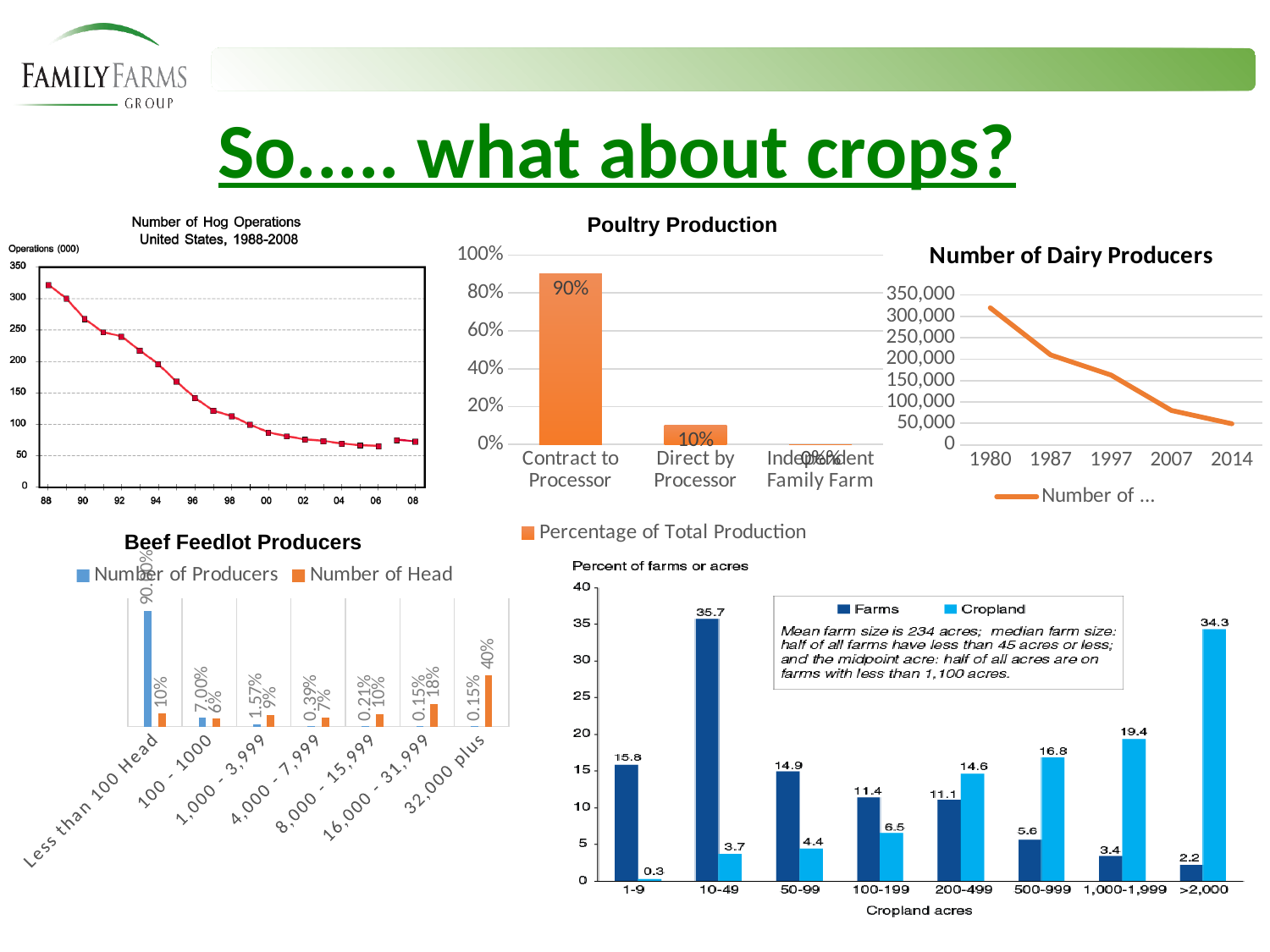
In the Number of Dairy Producers chart, is the value for 2014 greater or less than 100,000? less In the Poultry Production chart, how many categories are shown on the x axis? 3 In the Beef Feedlot Producers chart, how many series does the legend list? 2 In the Percent of farms or acres chart at the bottom right, what is the difference between the Farms and Cropland values for 1-9 acres? 15.5 In the Number of Hog Operations chart, is the value for 1988 greater or less than 300? greater In the Percent of farms or acres chart at the bottom right, which cropland acres category has the highest Farms value? 10-49 In the Beef Feedlot Producers chart, what is the Number of Head value for 32,000 plus? 40% In the Beef Feedlot Producers chart, which category has the highest Number of Producers value? Less than 100 Head In the Poultry Production chart, what is the value for Contract to Processor? 90% In the Percent of farms or acres chart at the bottom right, which is larger for 200-499 acres, Farms or Cropland? Cropland In the Number of Dairy Producers chart, do the values rise or fall from 1980 to 2014? fall In the Percent of farms or acres chart at the bottom right, what is the Cropland value for >2,000 acres? 34.3